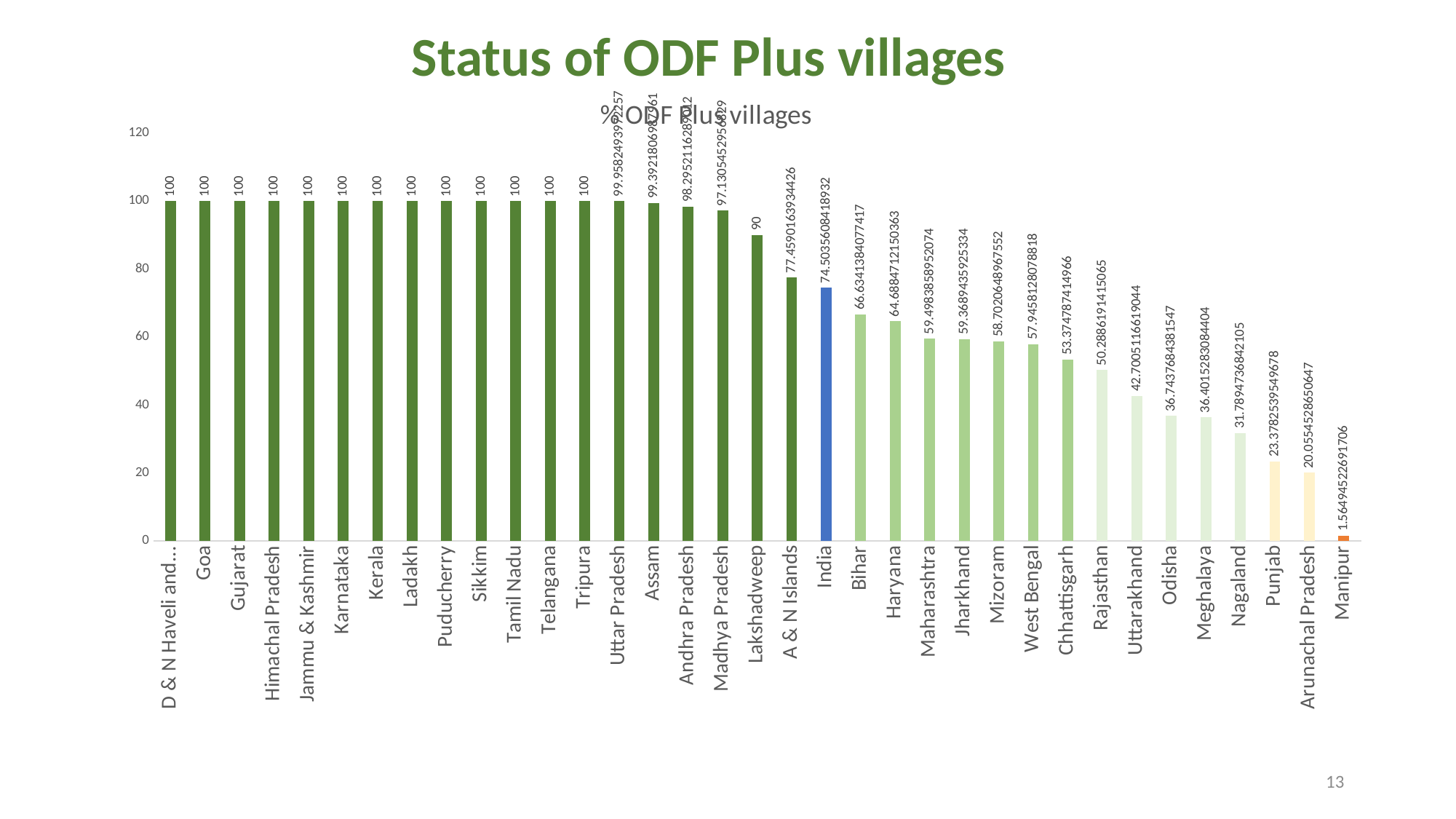
What is the value for India? 74.5035608418932 What is the value for Lakshadweep? 90 Is the value for Punjab greater or less than 40? less What is the value for Goa? 100 Which category has the lowest value? Manipur Which is larger, the value for Bihar or the value for Rajasthan? Bihar What is the difference between the value for Goa and the value for Lakshadweep? 10 How many categories are plotted on the x axis? 35 Is the value for Rajasthan greater or less than 40? greater What kind of chart is shown on the slide? bar chart Do the values generally rise or fall from left to right along the x axis? fall What is the title printed above the chart's plot area? % ODF Plus villages